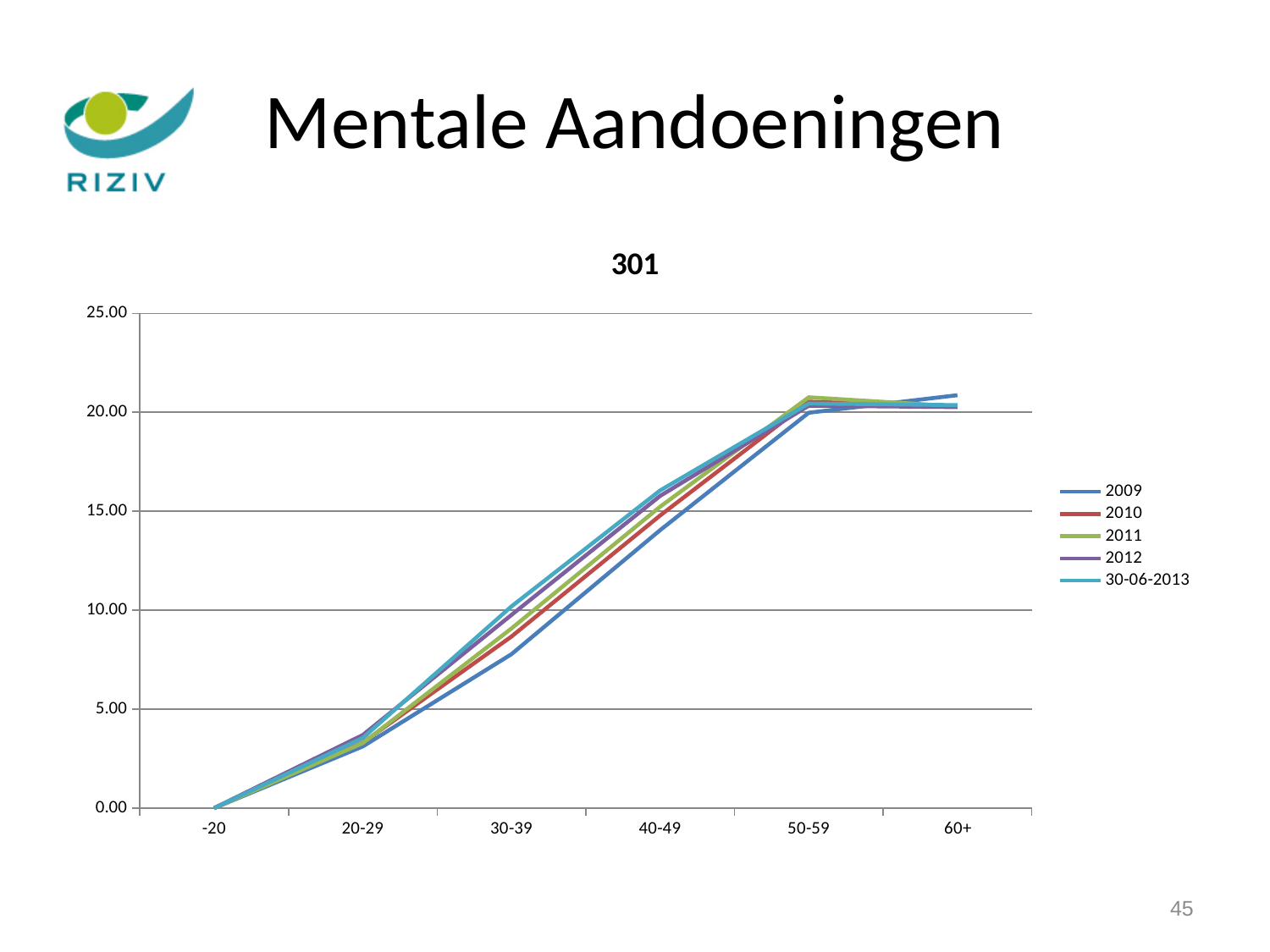
How many series does the legend list? 5 Is the value for 30-39 in the 2009 series greater or less than 10.00? less What kind of chart is shown on the slide? line chart Do the values for the 2010 series rise or fall from -20 to 50-59? rise What is the value for the -20 category for the 2009 series? 0.00 Which age category has the lowest value for the 2010 series? -20 Is the value for 20-29 in the 2012 series greater or less than 5.00? less Which series is listed last in the legend? 30-06-2013 At 30-39, which series has the larger value, 2009 or 30-06-2013? 30-06-2013 What is the title of the chart? 301 How many age categories are shown on the x axis? 6 Is the value for 50-59 in the 2011 series greater or less than 15.00? greater